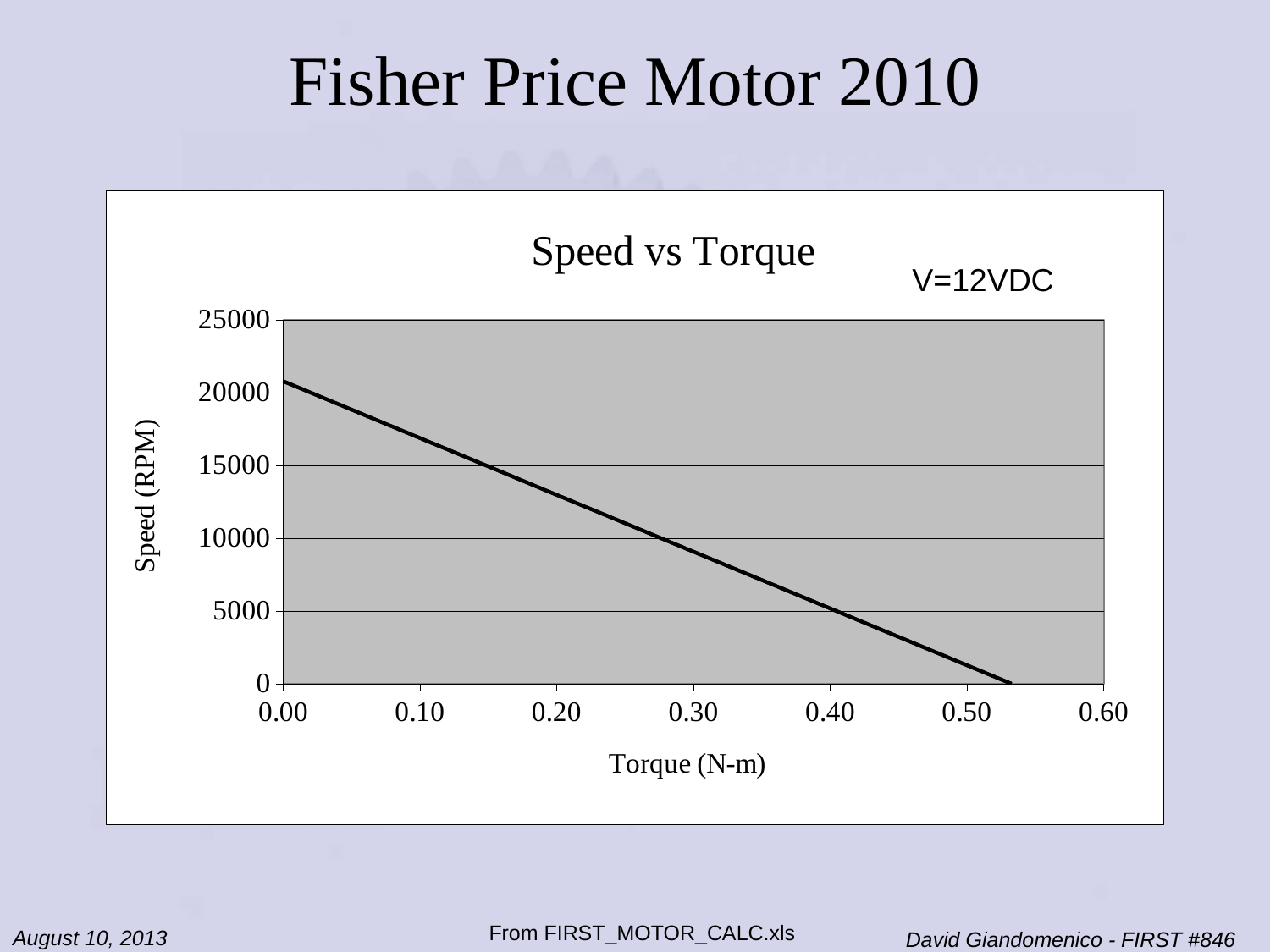
Is the speed at a torque of 0.10 N-m greater or less than 15000 RPM? greater What is the highest value shown on the y axis? 25000 Is the torque at which the speed reaches 0 RPM greater or less than 0.50 N-m? greater Is the speed at a torque of 0.50 N-m greater or less than 5000 RPM? less What is the label of the y axis? Speed (RPM) At which torque value on the x axis is the speed highest? 0.00 What kind of chart is shown on the slide? line chart Which has the higher speed: a torque of 0.10 N-m or a torque of 0.40 N-m? 0.10 N-m Does speed rise or fall as torque increases along the x axis? fall What is the title of the chart? Speed vs Torque